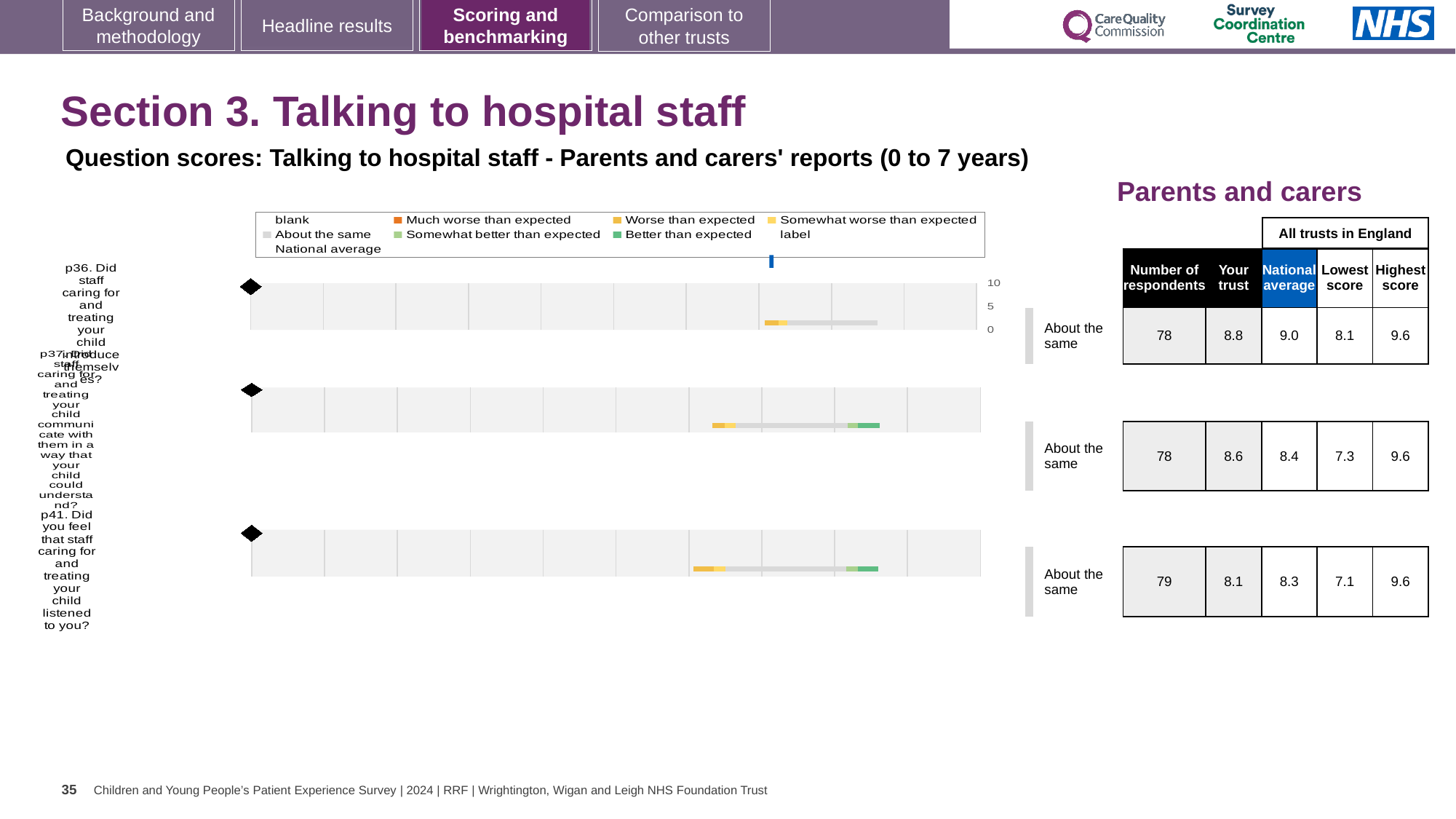
What benchmark category is shown next to each of the three bars? About the same Which of the three questions has the highest 'Your trust' score in the table? p36 What colour does the legend use for 'Better than expected'? green For p36, which is larger: the 'Your trust' score or the National average? National average In the table beside the chart, what is the Lowest score for p36? 8.1 What is the highest tick value shown on the chart's score axis? 10 In the table beside the chart, how many respondents are listed for p41 (Did you feel that staff listened to you)? 79 For p41, what is the difference between the Highest score and the Lowest score in the table? 2.5 What kind of chart is shown on the slide? bar chart In the table beside the chart, what is the 'Your trust' score for p36 (Did staff caring for and treating your child introduce themselves)? 8.8 In the table beside the chart, what is the National average for p37 (Did staff communicate with your child in a way they could understand)? 8.4 How many survey questions (rows) are plotted in the chart? 3